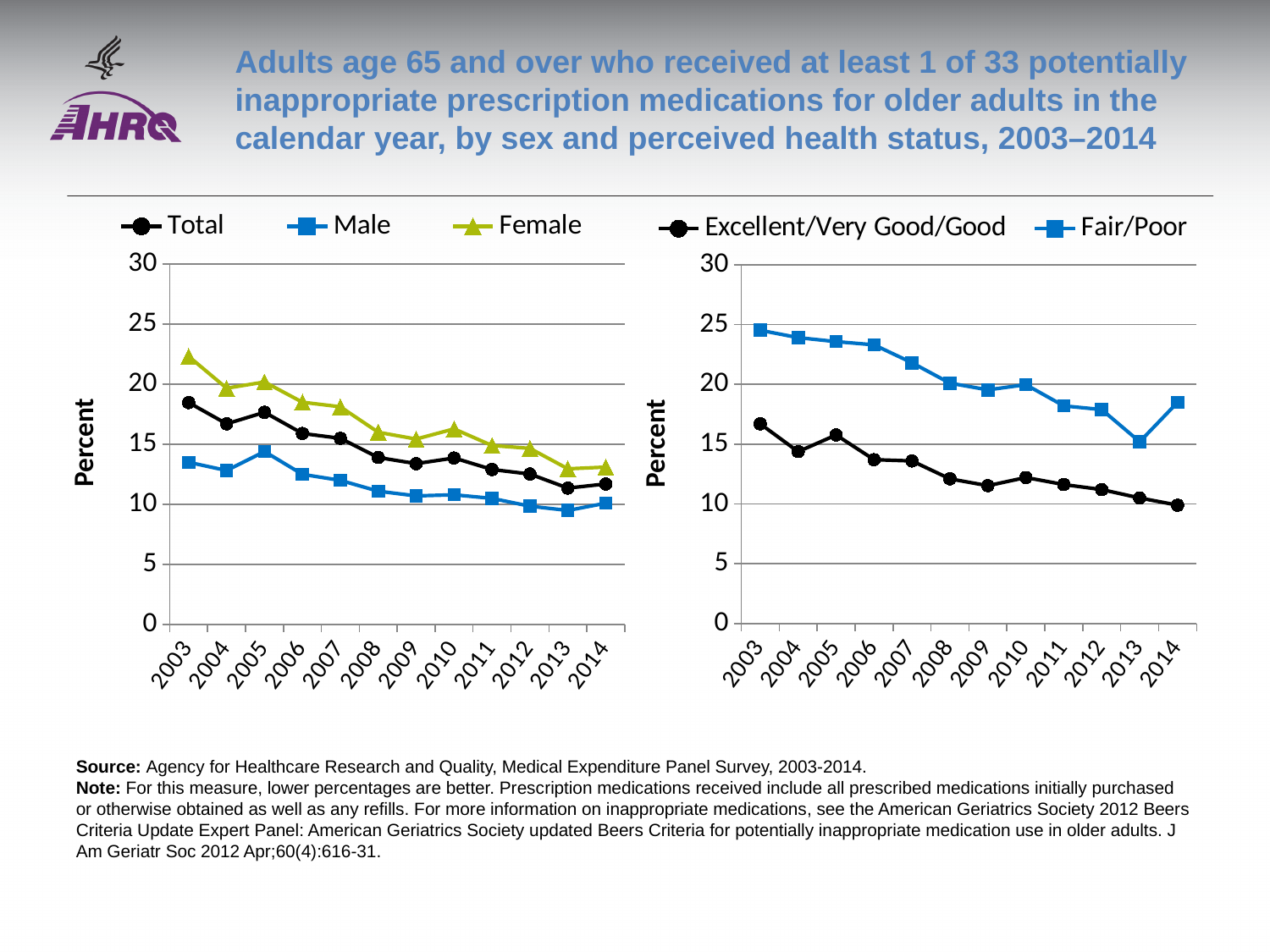
What kind of chart is the left chart (by sex)? line chart In the right chart (by perceived health status), which series has the higher value in 2014? Fair/Poor What is the label on the y axis of the right chart (by perceived health status)? Percent How many years are shown on the x axis of the left chart (by sex)? 12 In the left chart (by sex), is the Male value for 2003 greater or less than 15? less In the left chart (by sex), which series has the highest value in 2005? Female How many series does the legend of the right chart (by perceived health status) list? 2 In the left chart (by sex), which is larger in 2003, the Male value or the Female value? Female How many series does the legend of the left chart (by sex) list? 3 In the left chart (by sex), is the Female value for 2003 greater or less than 20? greater In the left chart (by sex), does the Female line generally rise or fall from 2003 to 2014? fall In the right chart (by perceived health status), is the Fair/Poor value for 2003 greater or less than 20? greater